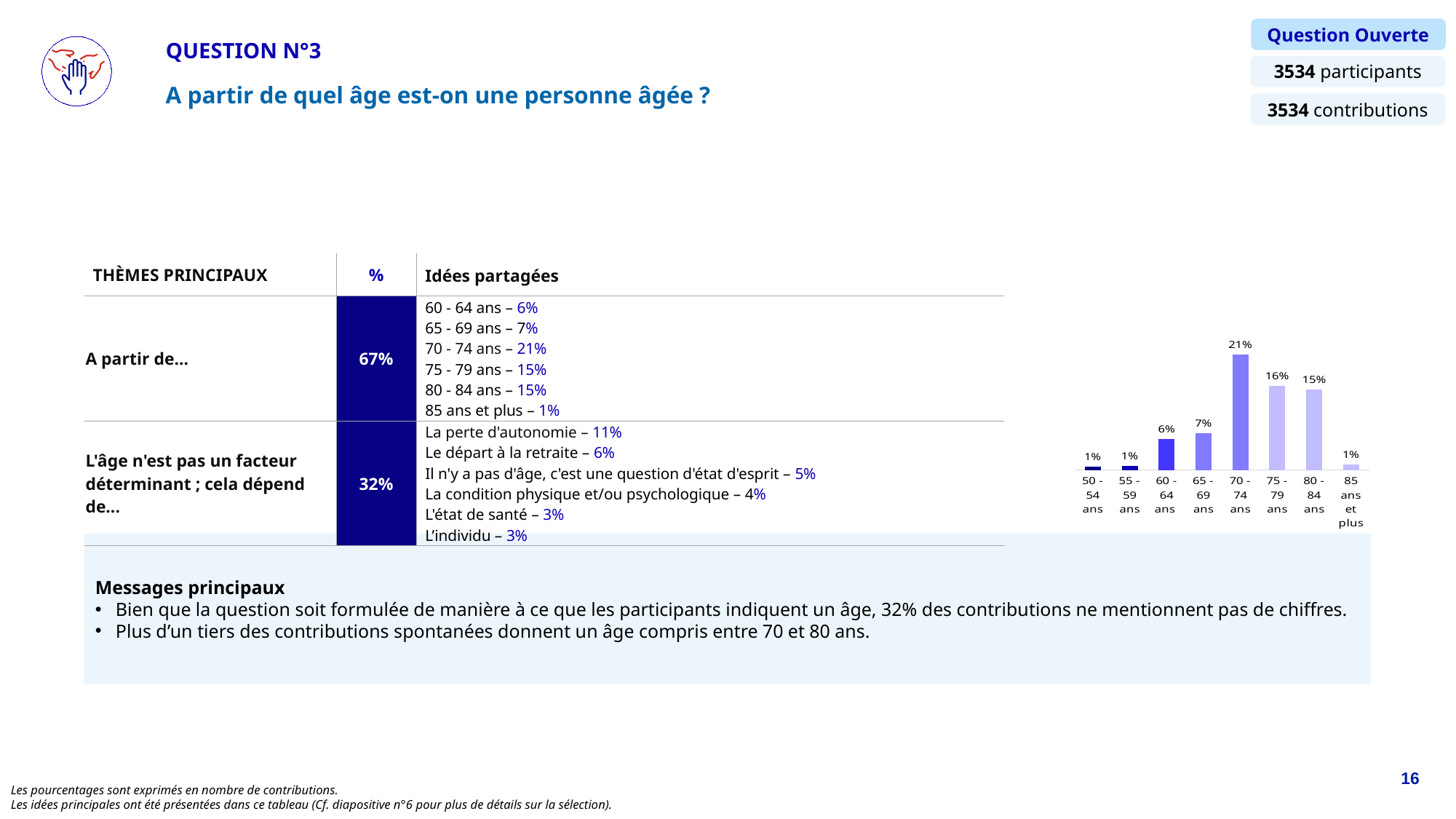
In the bar chart, what is the value for 70 - 74 ans? 21% In the bar chart, what is the value for 80 - 84 ans? 15% How many age categories are shown in the bar chart? 8 Which age category has the highest value in the bar chart? 70 - 74 ans In the bar chart, which is larger: the value for 75 - 79 ans or the value for 80 - 84 ans? 75 - 79 ans In the bar chart, what is the difference between the values for 65 - 69 ans and 60 - 64 ans? 1% In the bar chart, what is the value for 85 ans et plus? 1% In the bar chart, what is the difference between the values for 70 - 74 ans and 75 - 79 ans? 5% In the bar chart, which is larger: the value for 65 - 69 ans or the value for 55 - 59 ans? 65 - 69 ans What type of chart is shown on the slide? bar chart In the bar chart, what is the value for 60 - 64 ans? 6% In the bar chart, do the values rise or fall from 70 - 74 ans to 85 ans et plus? fall